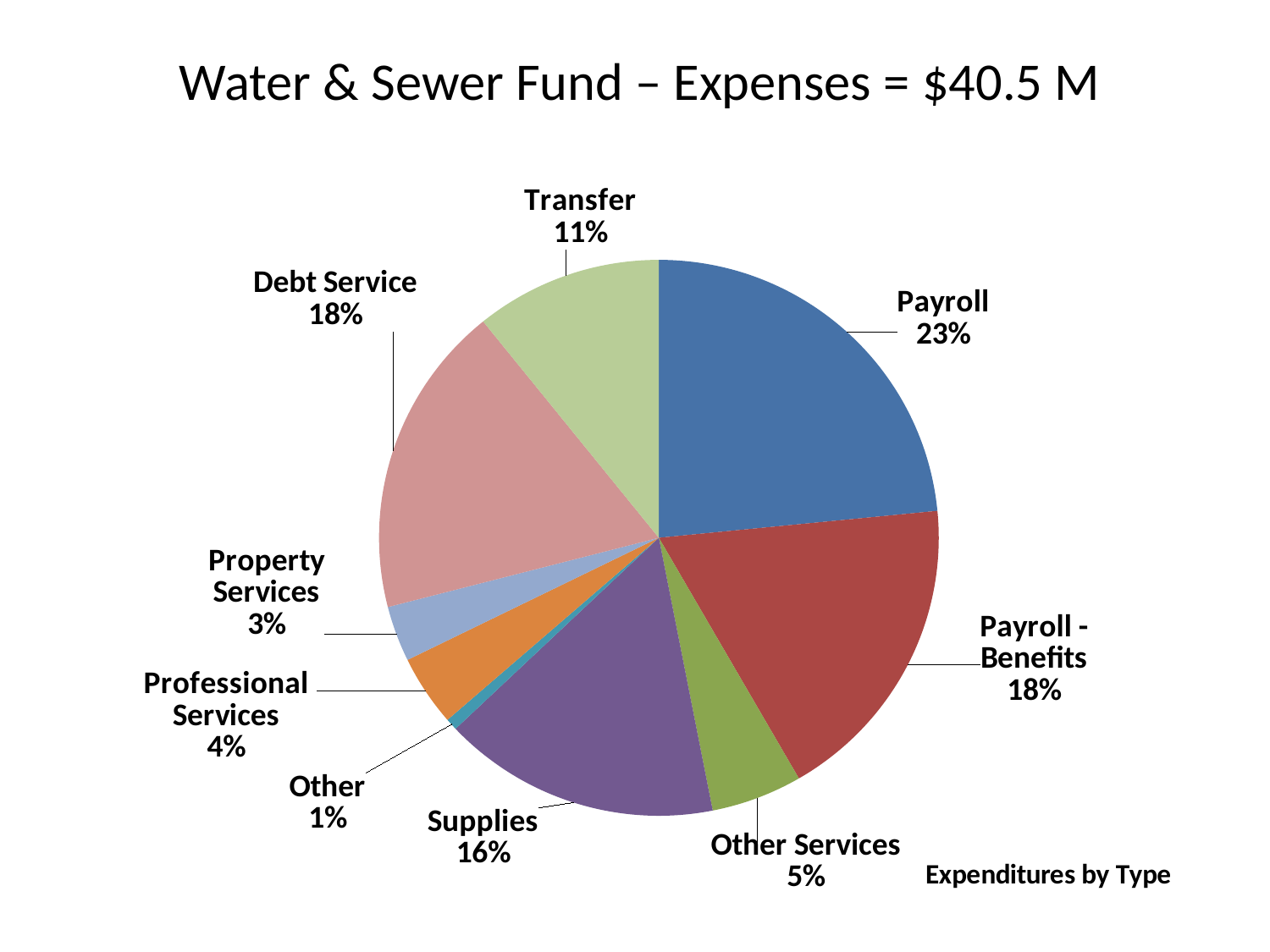
How many categories are shown in the pie chart? 9 Which category has the smallest share of expenses? Other What is the difference in percentage points between Payroll and Supplies? 7 What share of expenses is Supplies? 16% Which category has the largest share of expenses? Payroll What is the chart's title shown at the bottom right? Expenditures by Type What share of expenses is Transfer? 11% What share of expenses is Debt Service? 18% What kind of chart is shown on the slide? pie chart Which is larger, Other Services or Professional Services? Other Services What is the title of the slide? Water & Sewer Fund – Expenses = $40.5 M